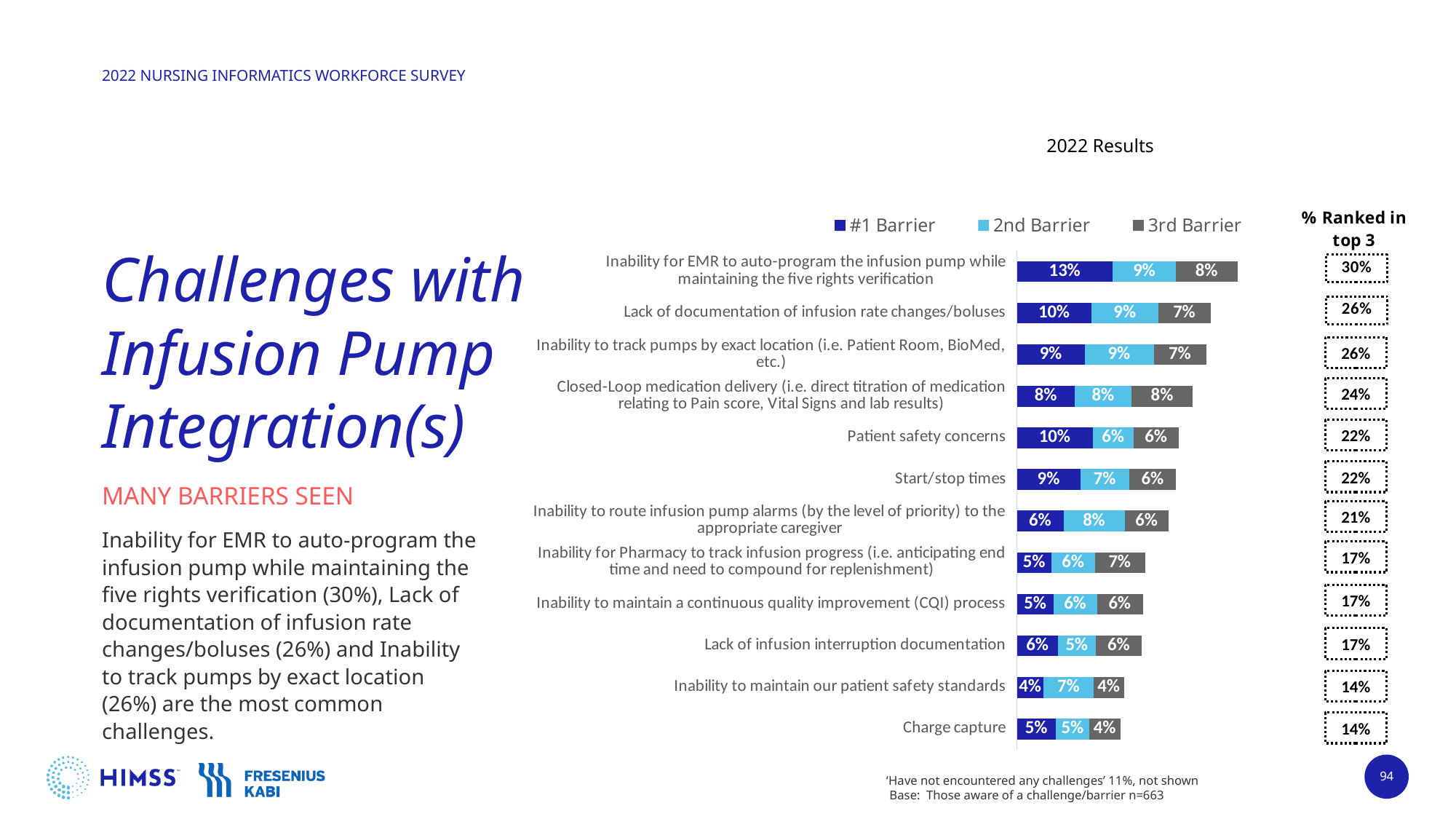
What is the difference between the #1 Barrier values for "Inability for EMR to auto-program the infusion pump while maintaining the five rights verification" and "Lack of documentation of infusion rate changes/boluses"? 3% What is the #1 Barrier value for "Patient safety concerns"? 10% What is the 2nd Barrier value for "Inability to maintain our patient safety standards"? 7% What is the total of the stacked bar for "Start/stop times"? 22% How many series does the legend list? 3 What is the total of the stacked bar for "Charge capture"? 14% How many categories (barriers) are shown in the chart? 12 Which category has the highest #1 Barrier value? Inability for EMR to auto-program the infusion pump while maintaining the five rights verification What kind of chart is shown on the slide? Stacked bar chart Which has the larger #1 Barrier value: "Patient safety concerns" or "Start/stop times"? Patient safety concerns What is the 3rd Barrier value for "Lack of documentation of infusion rate changes/boluses"? 7% Which category has the lowest #1 Barrier value? Inability to maintain our patient safety standards